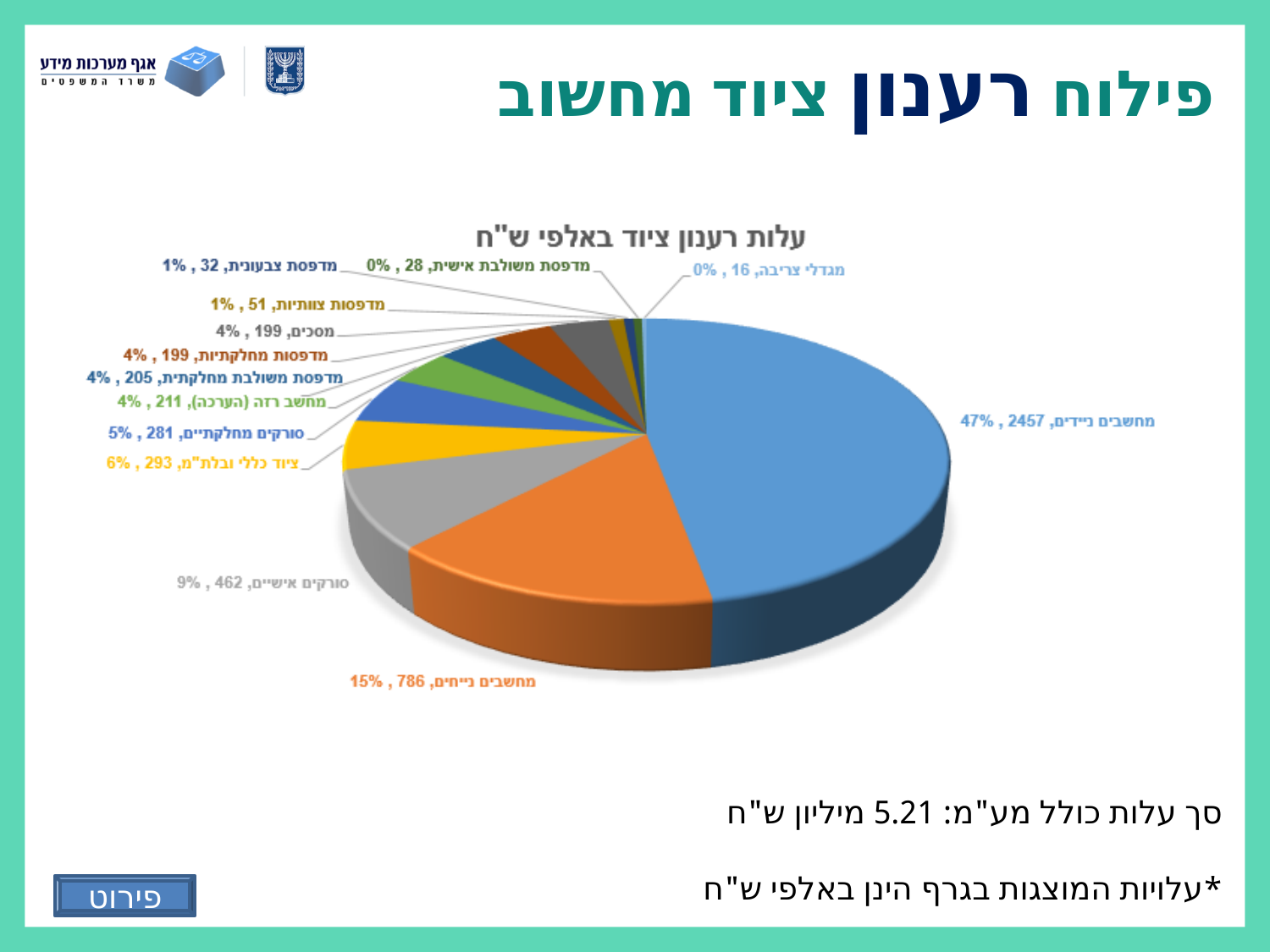
What share of the pie does מחשבים נייחים represent? 15% Which category has the largest slice of the pie? מחשבים ניידים What share of the pie does מחשב רזה (הערכה) represent? 4% What is the value shown for מדפסות צוותיות? 51 What is the value shown for מחשבים ניידים? 2457 How many categories are shown in the pie chart? 13 Which category has the smallest value in the chart? מגדלי צריבה What is the difference between the values for מחשבים ניידים and מחשבים נייחים? 1671 What is the value shown for סורקים אישיים? 462 What is the title of the chart? עלות רענון ציוד באלפי ש"ח Which is larger, the value for סורקים מחלקתיים or the value for ציוד כללי ובלת"מ? ציוד כללי ובלת"מ What kind of chart is shown on the slide? pie chart